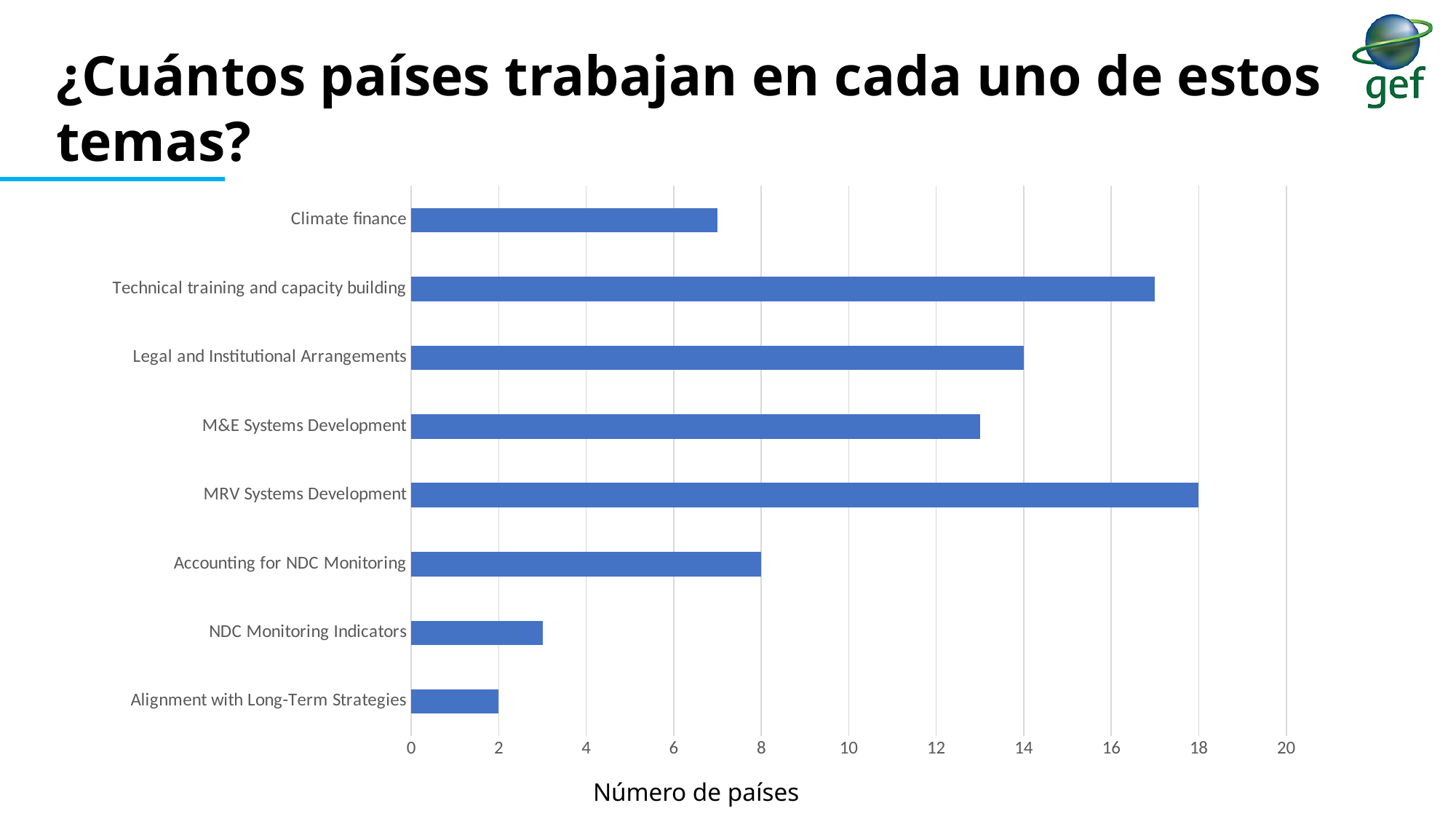
What is the title of the horizontal axis? Número de países What kind of chart is shown on the slide? bar chart Which category has the highest number of countries? MRV Systems Development What is the value for Alignment with Long-Term Strategies? 2 What is the difference between the values for MRV Systems Development and Accounting for NDC Monitoring? 10 What is the value for MRV Systems Development? 18 Is the value for Technical training and capacity building greater or less than 16? greater Which is larger, the value for M&E Systems Development or the value for Climate finance? M&E Systems Development What is the value for Accounting for NDC Monitoring? 8 Which category has the lowest number of countries? Alignment with Long-Term Strategies How many categories (topics) are shown in the chart? 8 What is the value for Legal and Institutional Arrangements? 14